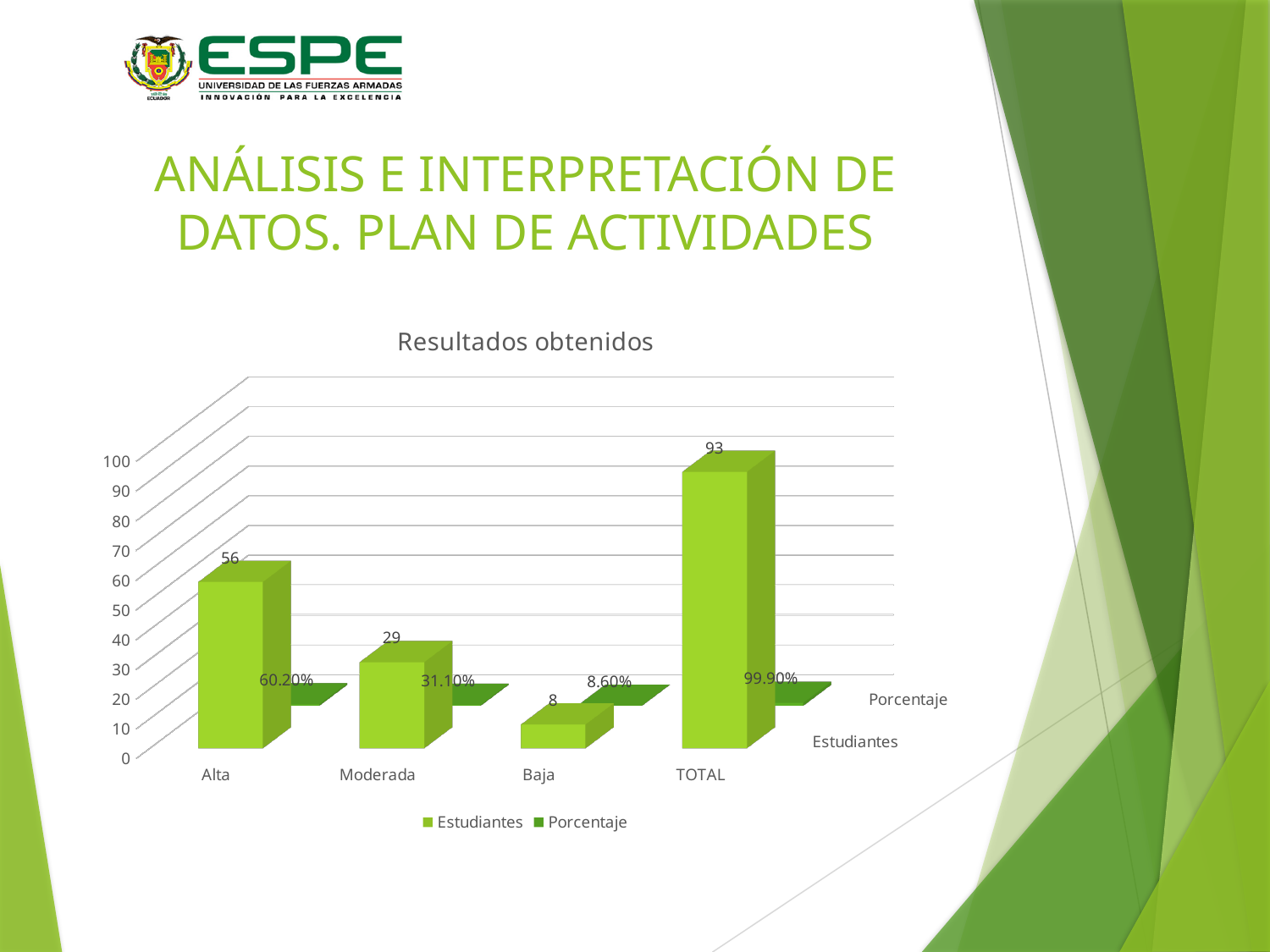
What is the title of the chart? Resultados obtenidos Which is larger, the Estudiantes value for Moderada or for Baja? Moderada What is the Porcentaje value for Alta? 60.20% What is the Estudiantes value for Alta? 56 What is the difference between the Estudiantes values for Alta and Moderada? 27 What is the Estudiantes value for Moderada? 29 How many series does the legend list? 2 What is the Porcentaje value for TOTAL? 99.90% What is the Estudiantes value for Baja? 8 Which category has the lowest Estudiantes value? Baja How many categories are shown on the x axis? 4 Which category has the highest Estudiantes value? TOTAL